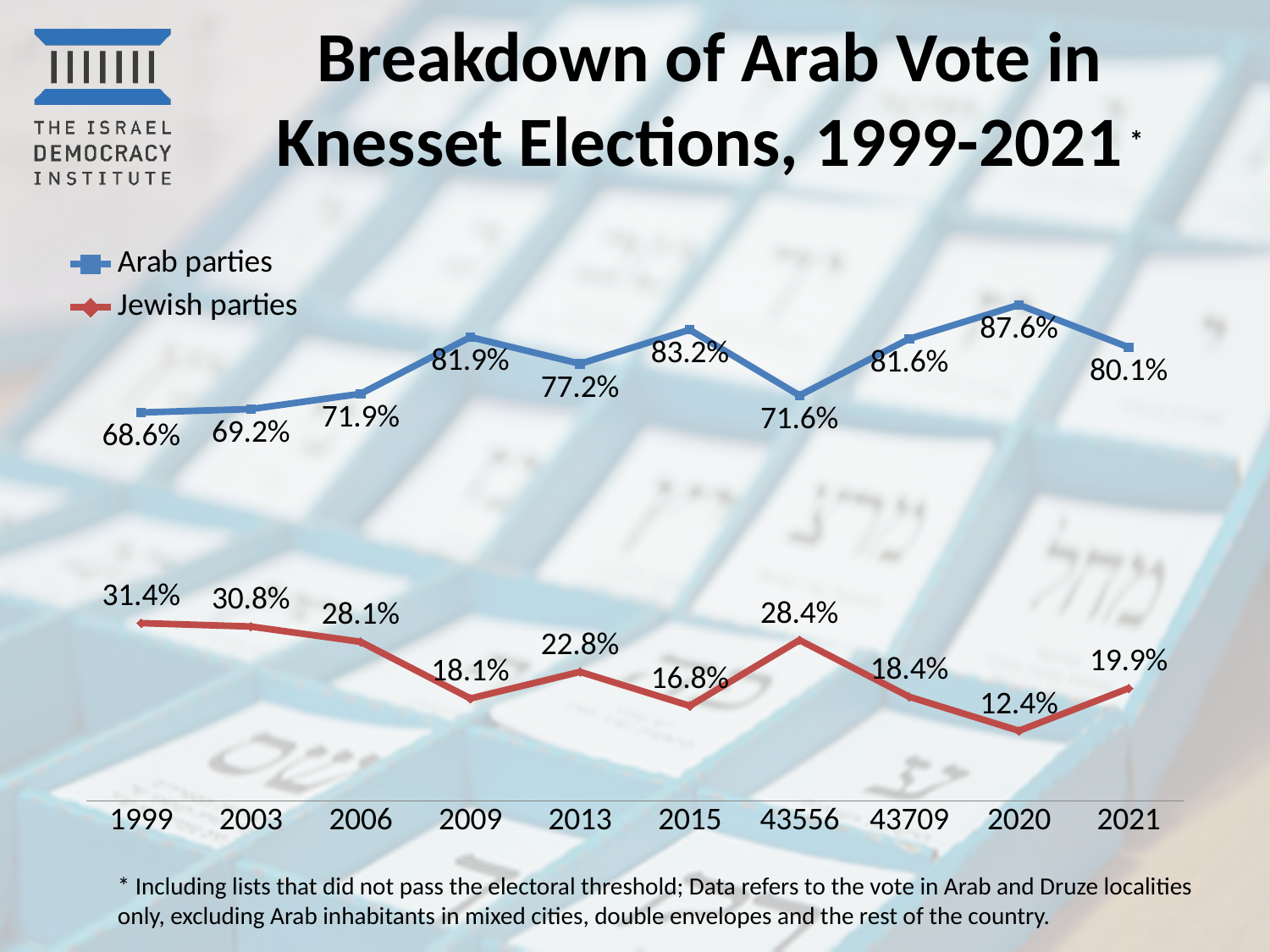
What is the value for Arab parties in 2009? 81.9% What colour is the line for Arab parties? Blue What is the value for Jewish parties in 2013? 22.8% How many x-axis categories are plotted on the chart? 10 What is the value for Arab parties in 2021? 80.1% In which year is the Jewish parties value lowest? 2020 How many series does the legend list? 2 What kind of chart is shown on the slide? Line chart What is the difference between the Arab parties value in 2020 and in 2021? 7.5% Which is larger: the Jewish parties value in 1999 or in 2015? 1999 Does the Jewish parties value rise or fall from 1999 to 2006? Fall In which year is the Arab parties value highest? 2020